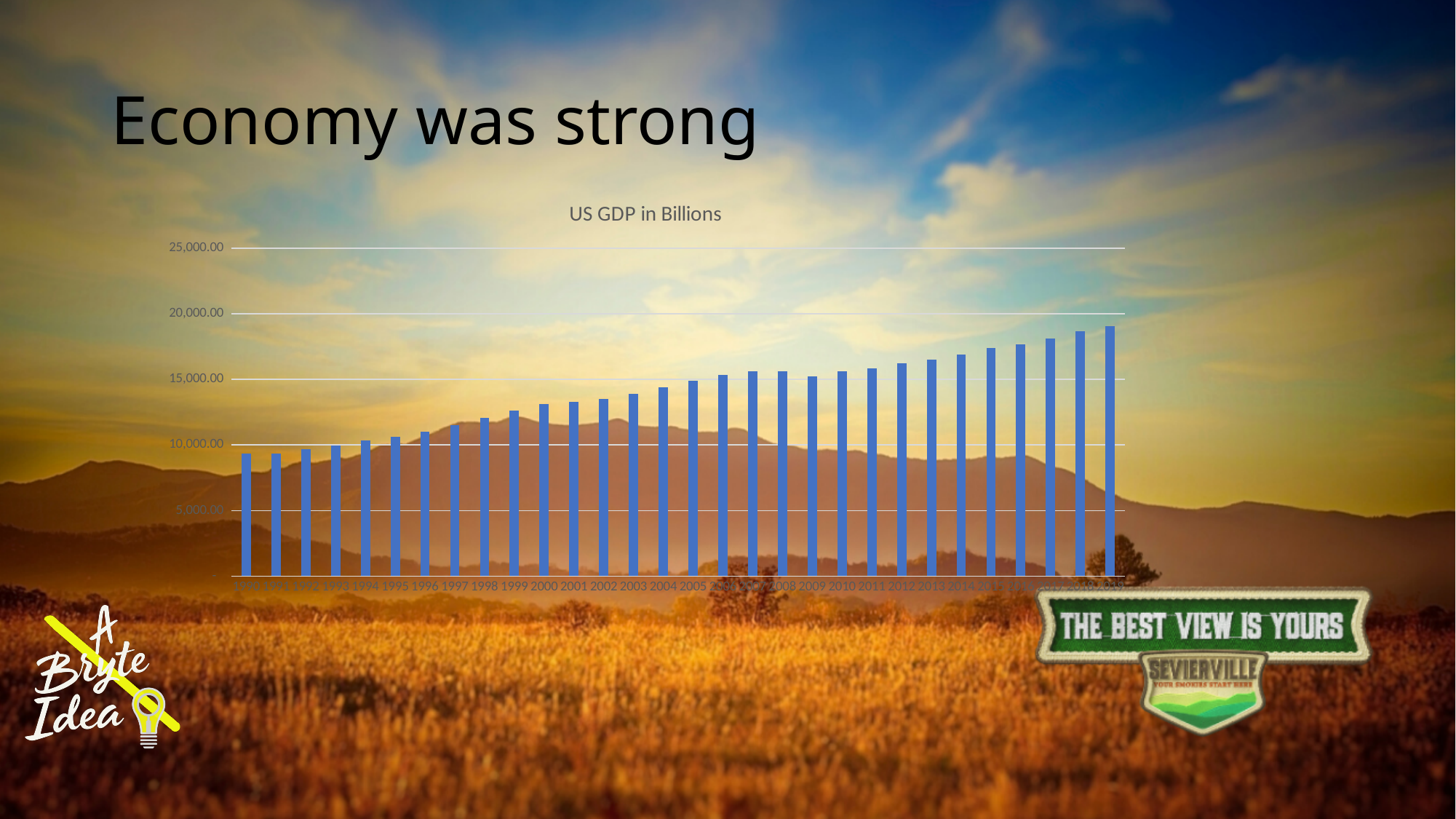
What colour are the bars in the chart? blue Is the value for 2010 greater or less than 15,000.00? greater Is the value for 2014 greater or less than 15,000.00? greater Which year has the highest US GDP in the chart? 2019 What is the title of the chart? US GDP in Billions Do the GDP values generally rise or fall from 1990 to 2019? rise Is the value for 1990 greater or less than 10,000.00? less What kind of chart is shown on the slide? bar chart How many years (bars) are plotted in the chart? 30 Which is larger, the value for 2019 or the value for 1990? 2019